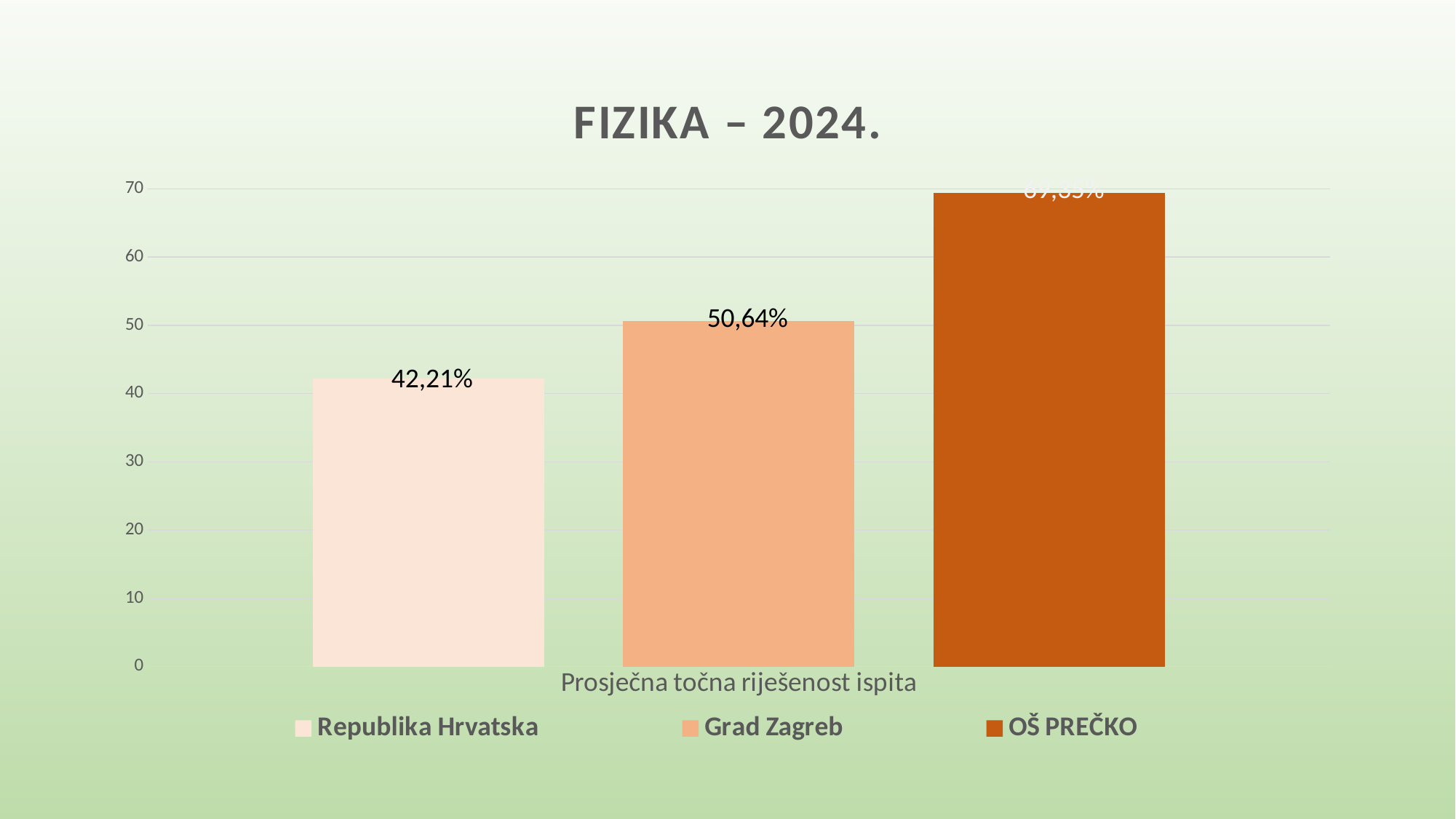
Which series has the highest value? OŠ PREČKO Which is larger, the value for Grad Zagreb or the value for Republika Hrvatska? Grad Zagreb What is the label on the category axis? Prosječna točna riješenost ispita What is the value for Republika Hrvatska? 42,21% Which series has the lowest value? Republika Hrvatska What is the title of the chart? FIZIKA – 2024. How many series does the legend list? 3 What is the value for Grad Zagreb? 50,64% Is the value for Republika Hrvatska greater or less than 50? less What is the difference between the values for Grad Zagreb and Republika Hrvatska? 8,43% Is the value for OŠ PREČKO greater or less than 60? greater What kind of chart is shown on the slide? bar chart